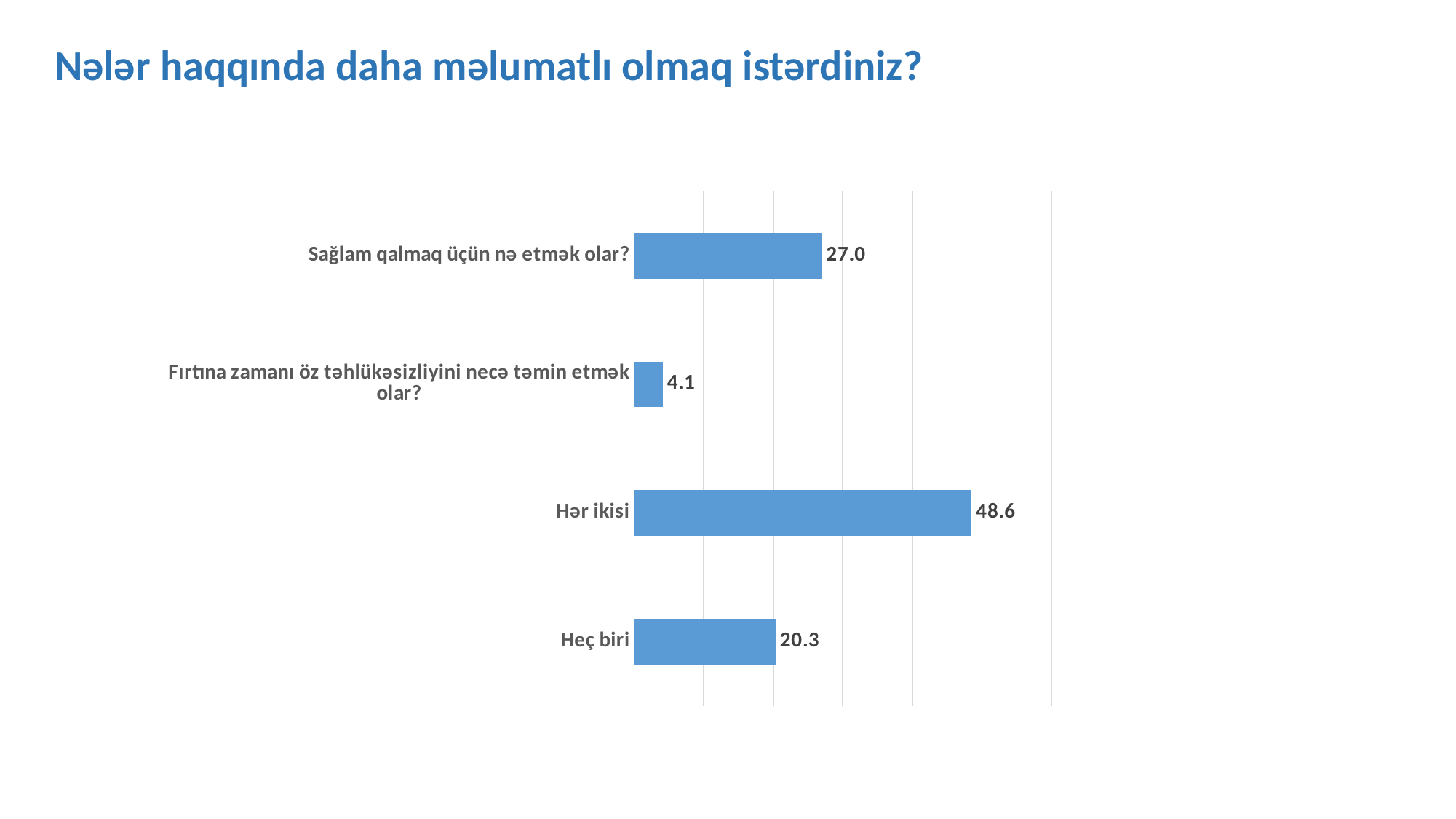
Which category has the highest value? Hər ikisi What is the difference between the values for "Heç biri" and "Fırtına zamanı öz təhlükəsizliyini necə təmin etmək olar?"? 16.2 What is the value for "Heç biri"? 20.3 Which category has the lowest value? Fırtına zamanı öz təhlükəsizliyini necə təmin etmək olar? What is the value for "Hər ikisi"? 48.6 What is the difference between the values for "Hər ikisi" and "Sağlam qalmaq üçün nə etmək olar?"? 21.6 Which is larger, the value for "Sağlam qalmaq üçün nə etmək olar?" or the value for "Heç biri"? Sağlam qalmaq üçün nə etmək olar? What is the value for "Sağlam qalmaq üçün nə etmək olar?"? 27.0 What is the value for "Fırtına zamanı öz təhlükəsizliyini necə təmin etmək olar?"? 4.1 How many categories are shown in the chart? 4 What kind of chart is shown on the slide? Bar chart What is the title of the slide? Nələr haqqında daha məlumatlı olmaq istərdiniz?